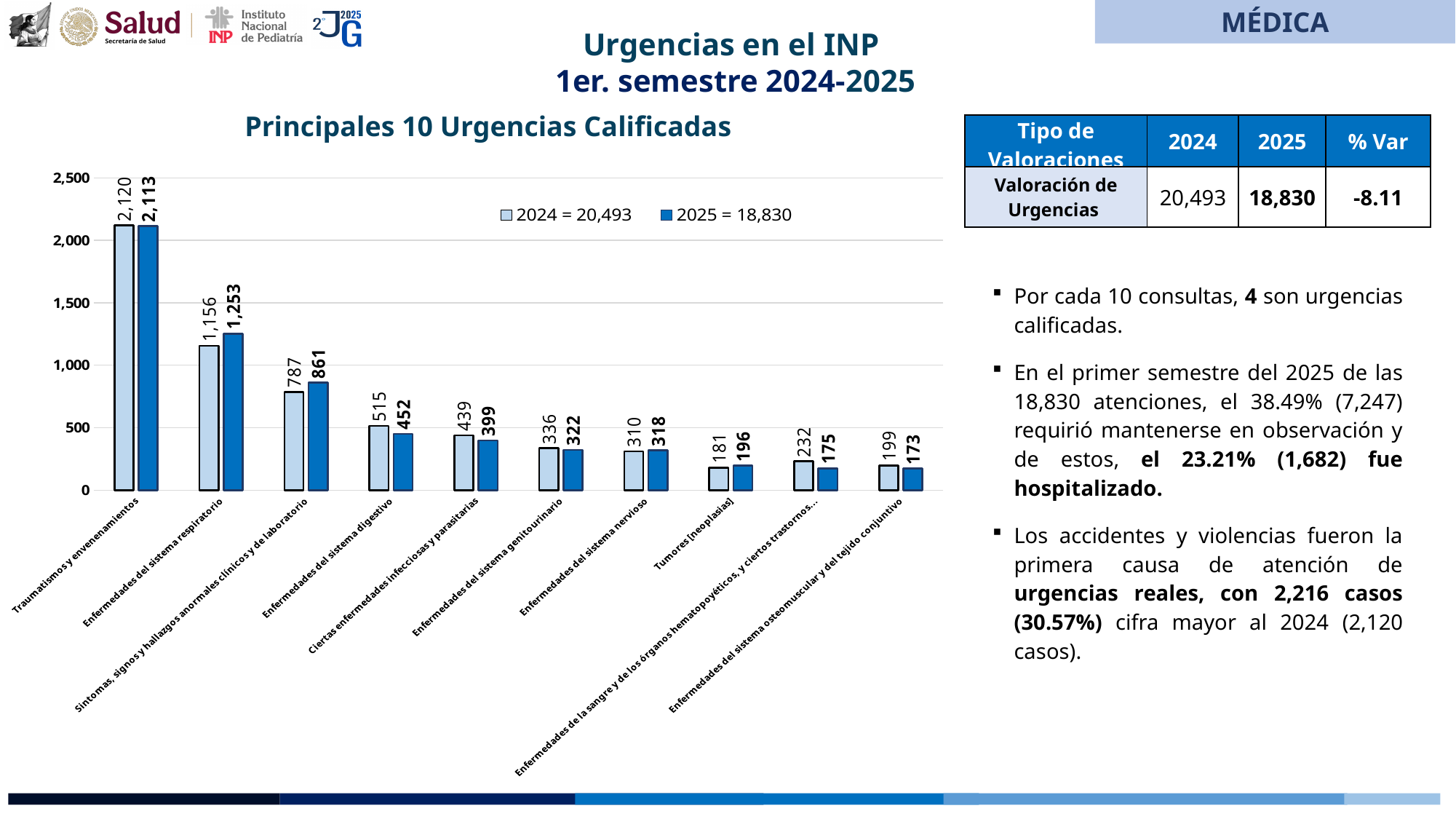
What is the difference between the 2024 and 2025 values for "Síntomas, signos y hallazgos anormales clínicos y de laboratorio"? 74 What total does the legend show for the 2025 series? 18,830 How many categories are plotted on the x axis of the chart? 10 Is the 2025 value for "Ciertas enfermedades infecciosas y parasitarias" greater or less than 500? less For "Enfermedades de la sangre y de los órganos hematopoyéticos...", which is larger, the 2024 value or the 2025 value? 2024 What is the 2025 value for "Tumores [neoplasias]"? 196 How many series does the legend of the chart list? 2 Which category has the lowest 2025 value? Enfermedades del sistema osteomuscular y del tejido conjuntivo Which category has the highest 2024 value? Traumatismos y envenenamientos What is the 2025 value for "Enfermedades del sistema respiratorio"? 1,253 What type of chart is shown under the title "Principales 10 Urgencias Calificadas"? Bar chart What is the 2024 value for "Enfermedades del sistema digestivo"? 515